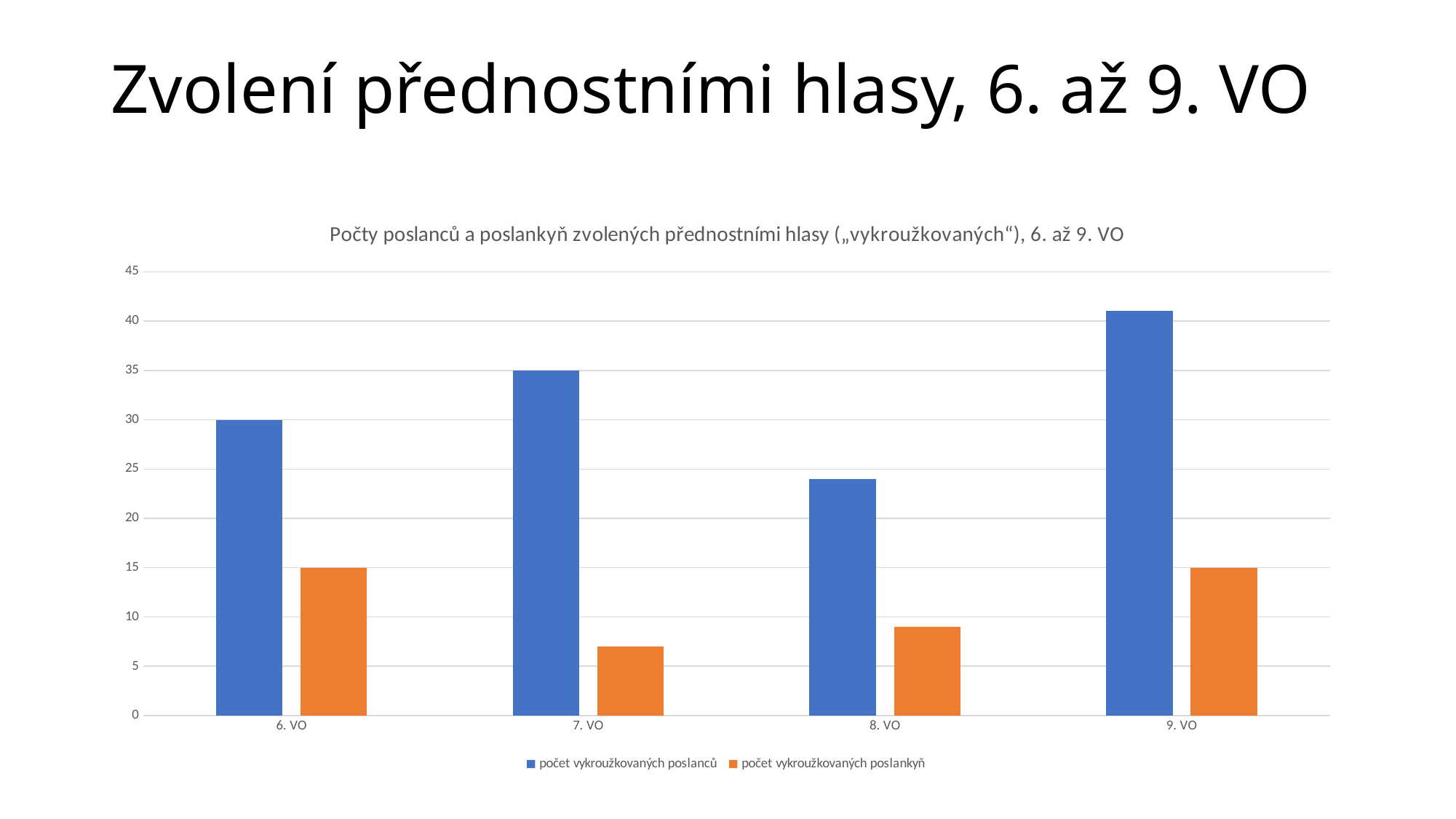
What type of chart is shown on the slide? bar chart What is the value of 'počet vykroužkovaných poslankyň' for 6. VO? 15 Which category has the lowest value for 'počet vykroužkovaných poslanců'? 8. VO Which category has the highest value for 'počet vykroužkovaných poslanců'? 9. VO How many categories (election periods) are shown on the x axis? 4 Is the value of 'počet vykroužkovaných poslanců' for 9. VO greater or less than 40? greater What is the value of 'počet vykroužkovaných poslanců' for 7. VO? 35 How many series does the legend list? 2 What is the difference between 'počet vykroužkovaných poslanců' and 'počet vykroužkovaných poslankyň' for 6. VO? 15 Is the value of 'počet vykroužkovaných poslankyň' for 7. VO greater or less than 10? less What is the value of 'počet vykroužkovaných poslankyň' for 9. VO? 15 What is the value of 'počet vykroužkovaných poslanců' for 6. VO? 30